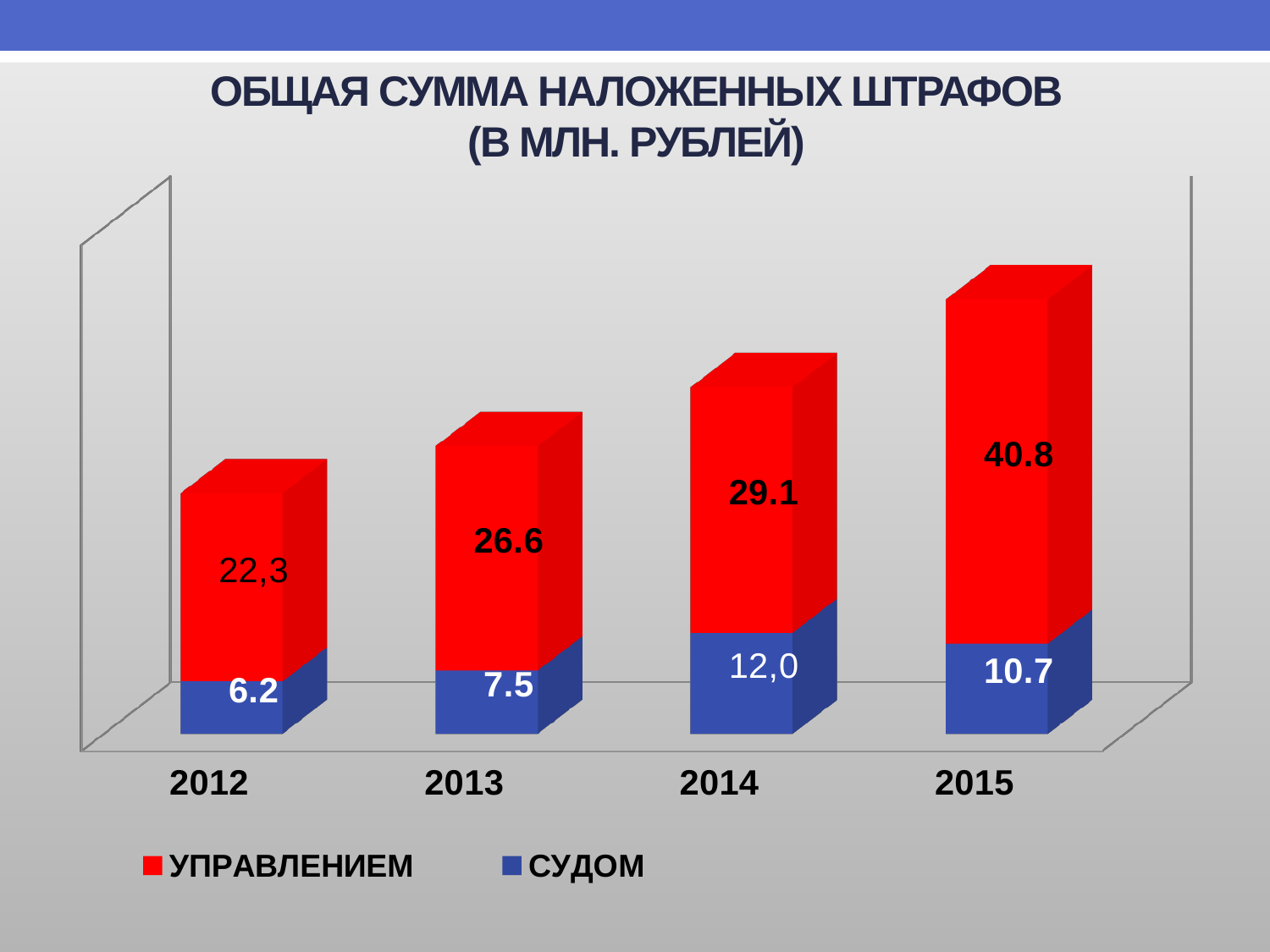
In which year is the value for УПРАВЛЕНИЕМ highest? 2015 What is the value for УПРАВЛЕНИЕМ in 2012? 22,3 What is the value for СУДОМ in 2014? 12,0 What is the value for СУДОМ in 2013? 7.5 Which is larger: the СУДОМ value for 2014 or for 2015? 2014 What is the difference between the СУДОМ values for 2015 and 2013? 3.2 In which year is the value for СУДОМ lowest? 2012 What is the difference between the УПРАВЛЕНИЕМ values for 2015 and 2014? 11.7 How many years are shown on the x axis? 4 What is the total of the stacked bar for 2015? 51.5 What is the value for УПРАВЛЕНИЕМ in 2015? 40.8 How many series does the legend list? 2